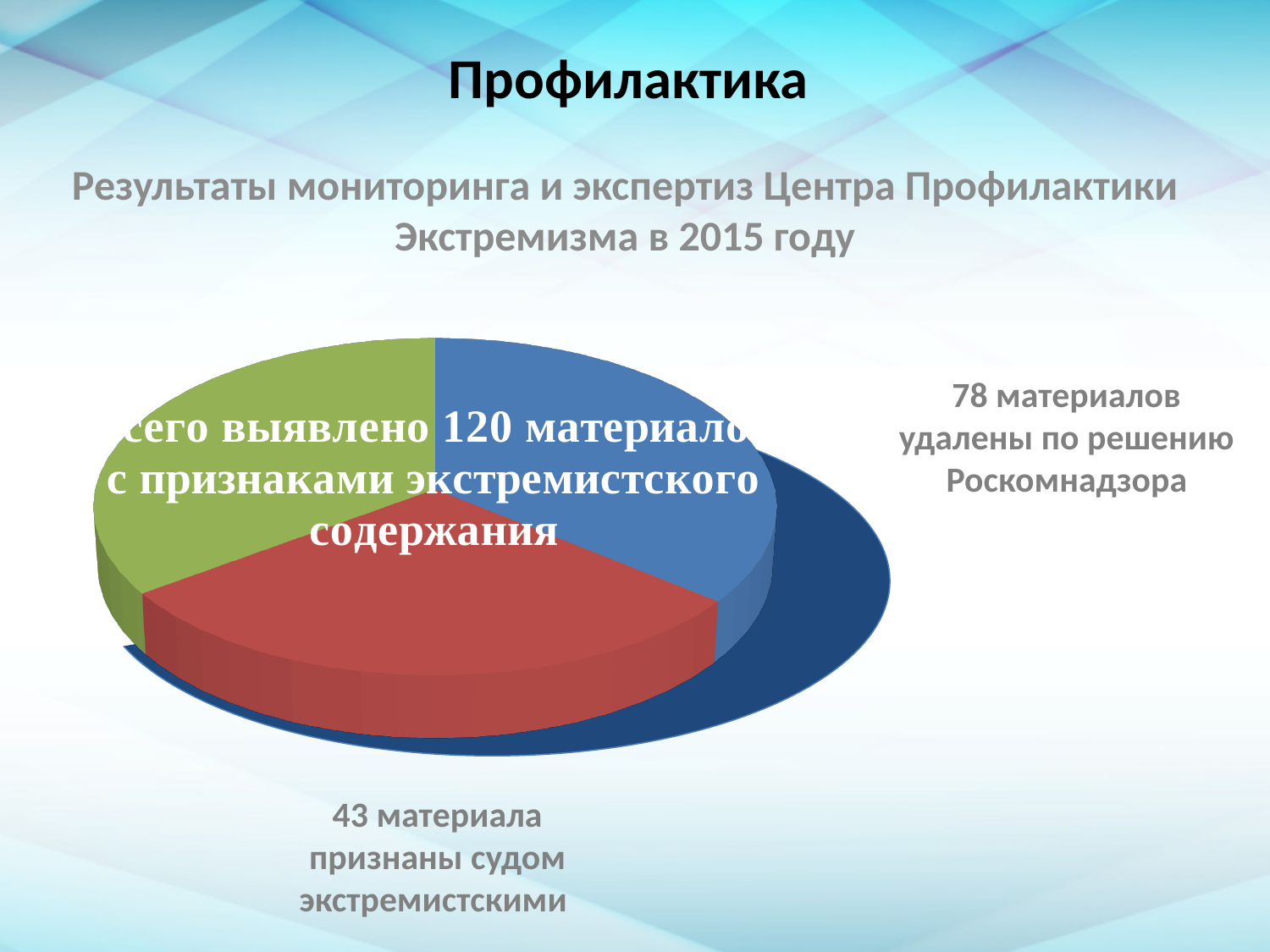
According to the text on the pie chart, how many materials with signs of extremist content were identified in total? 120 How many slices does the pie chart have? 3 What colours are the slices of the pie chart? blue, red and green What is the heading above the pie chart? Результаты мониторинга и экспертиз Центра Профилактики Экстремизма в 2015 году Which is larger: the number of materials removed by decision of Roskomnadzor or the number recognised by the court as extremist? removed by decision of Roskomnadzor What is the difference between the number of materials removed by Roskomnadzor (78) and the number recognised by the court as extremist (43)? 35 According to the label below the pie chart, how many materials were recognised by the court as extremist? 43 What kind of chart is shown on the slide? pie chart According to the label next to the pie chart, how many materials were removed by decision of Roskomnadzor? 78